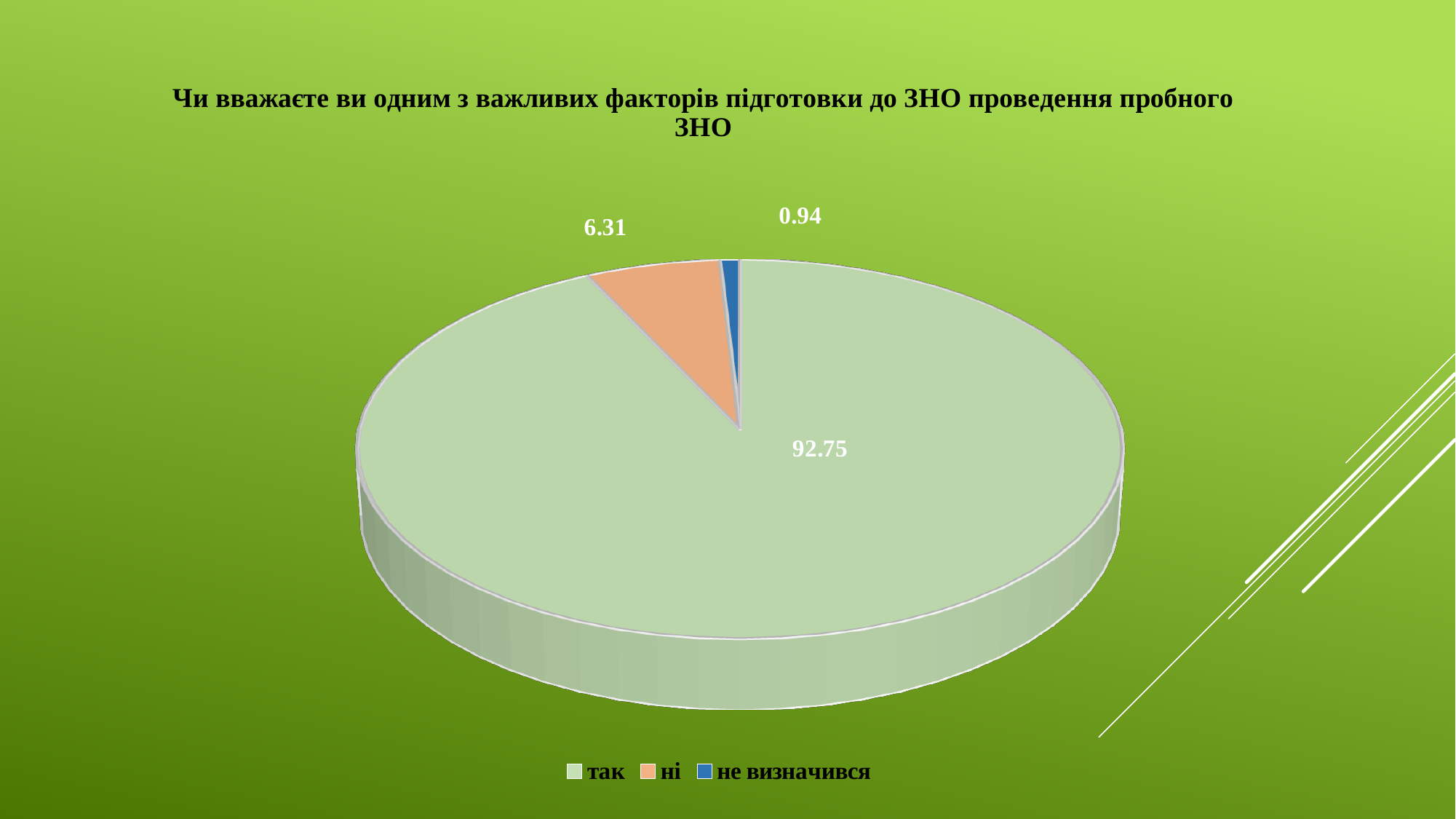
What is the value for "ні"? 6.31 Which is larger, the value for "ні" or the value for "не визначився"? ні What is the value for "так"? 92.75 How many categories does the pie chart have? 3 Which category has the largest slice? так What is the difference between the values for "ні" and "не визначився"? 5.37 What colour is the slice for "ні"? orange What is the difference between the values for "так" and "ні"? 86.44 Which category has the smallest slice? не визначився How many entries does the legend list? 3 What is the value for "не визначився"? 0.94 What kind of chart is shown on the slide? pie chart